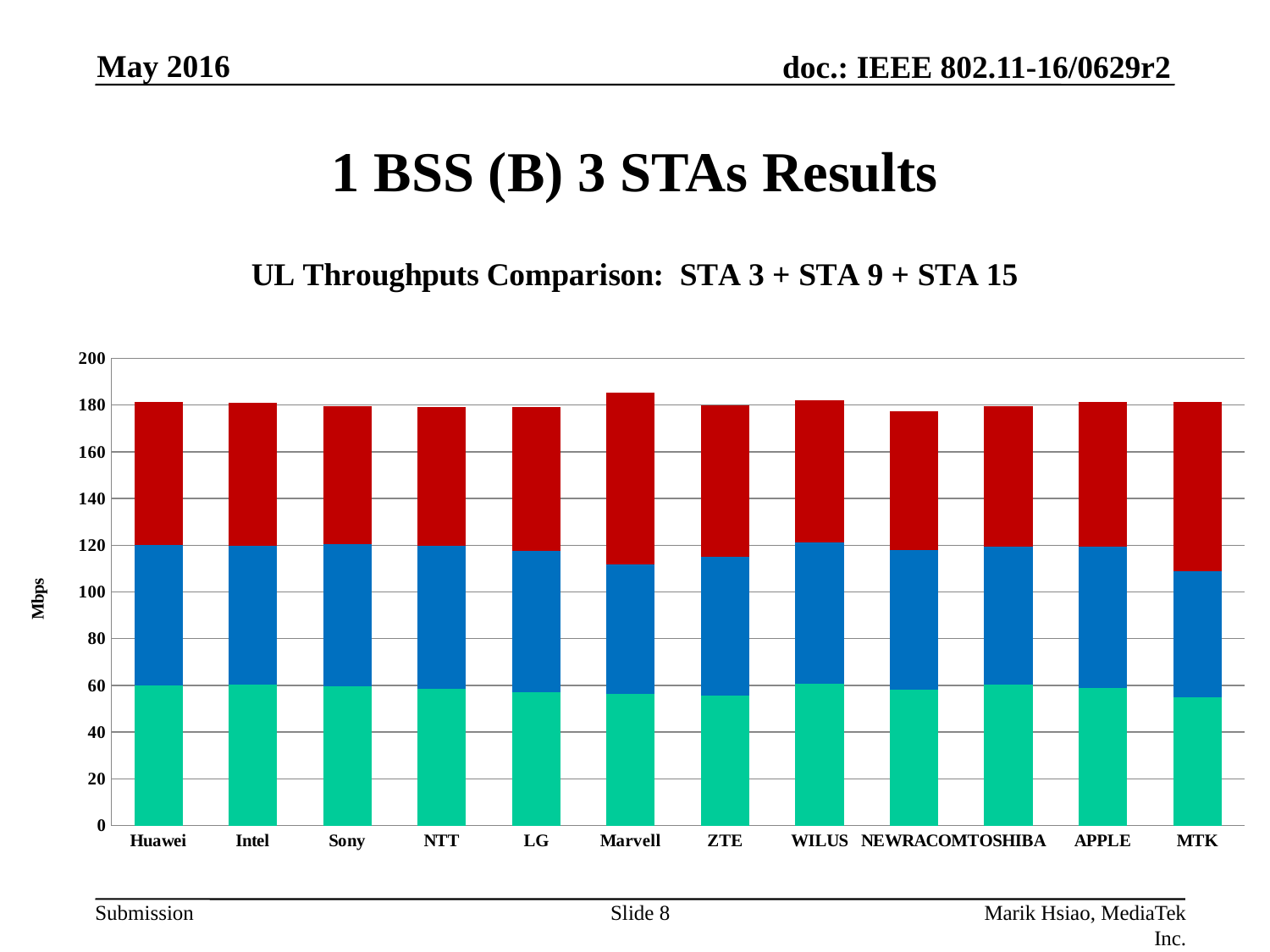
Is the total stacked value for Huawei greater or less than 160? greater Is the total stacked value for Marvell greater or less than 180? greater Which company has the highest total stacked bar in the chart? Marvell Is the top of the blue segment for Huawei greater or less than 100? greater Which has the larger total stacked bar, Marvell or MTK? Marvell Which has the larger total stacked bar, Marvell or NEWRACOM? Marvell How many companies are shown along the x axis of the chart? 12 What is the title of the chart? UL Throughputs Comparison: STA 3 + STA 9 + STA 15 What kind of chart is shown on the slide? stacked bar chart What unit is shown on the y axis of the chart? Mbps